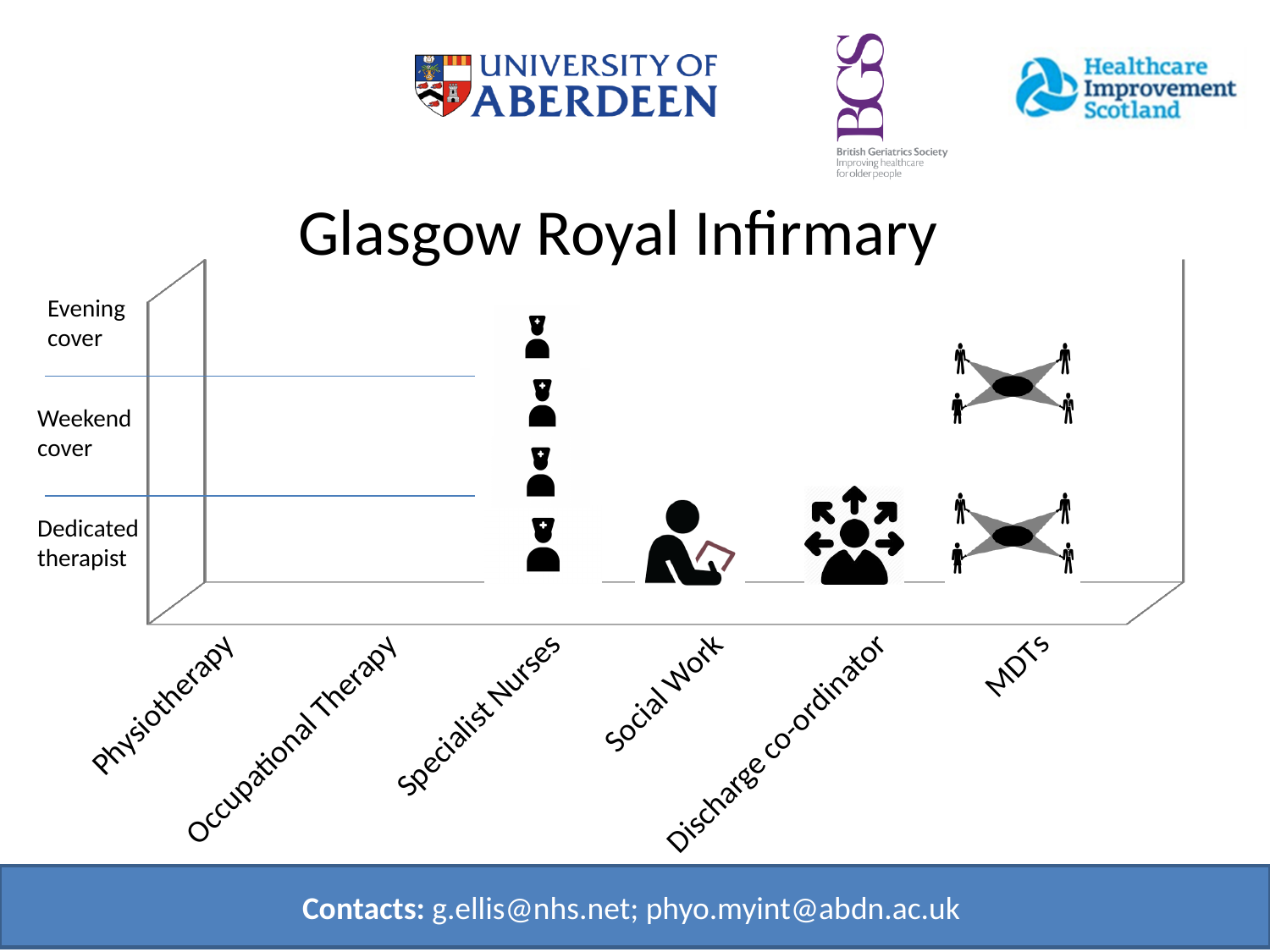
What is the highest level on the y axis reached by the Specialist Nurses stack? Evening cover How many nurse icons are stacked for Specialist Nurses? 4 Which category has the tallest stack of icons? Specialist Nurses Which categories have no icons plotted? Physiotherapy and Occupational Therapy What are the three levels labelled on the y axis, from bottom to top? Dedicated therapist, Weekend cover, Evening cover What is the title of the chart? Glasgow Royal Infirmary How many categories are shown along the x axis? 6 Which is taller, the stack for Specialist Nurses or the stack for MDTs? Specialist Nurses Which is taller, the stack for MDTs or the icon for Social Work? MDTs How many icons are shown for MDTs? 2 Does the Social Work icon reach above the Dedicated therapist level? No